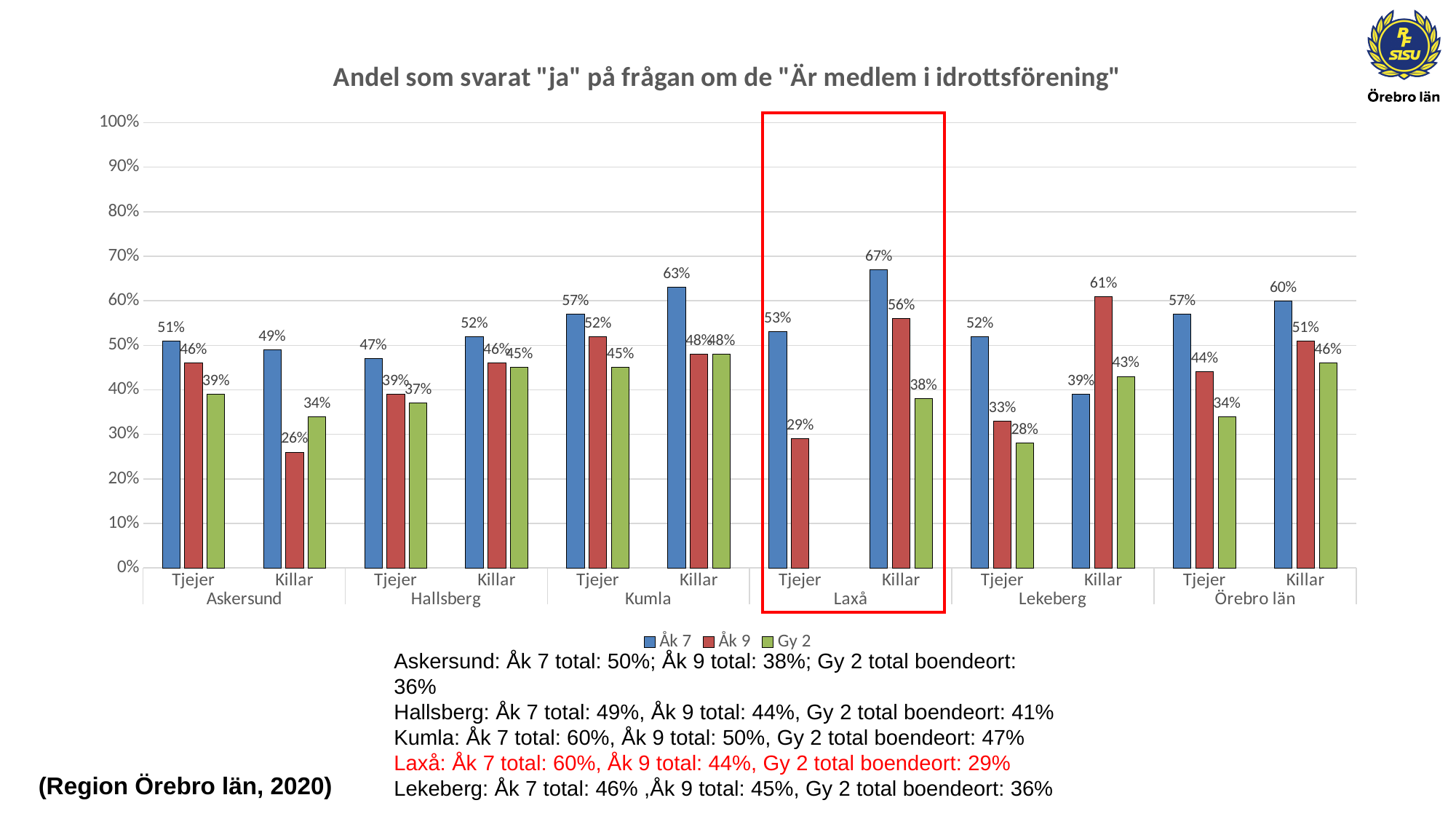
What is the Gy 2 value for Tjejer in Lekeberg? 28% Which municipality is highlighted with a red box on the chart? Laxå Which group has the lowest Åk 9 value? Killar, Askersund What is the Åk 7 value for Killar in Örebro län? 60% What is the Åk 7 value for Killar in Laxå? 67% What is the difference between the Åk 7 value and the Åk 9 value for Tjejer in Laxå? 24 percentage points What kind of chart is shown on the slide? Bar chart What is the Åk 9 value for Killar in Lekeberg? 61% Which is larger for Killar in Lekeberg: the Åk 7 value or the Åk 9 value? Åk 9 Which group has the highest Åk 7 value? Killar, Laxå What is the Åk 9 value for Killar in Askersund? 26% How many series does the legend list? 3